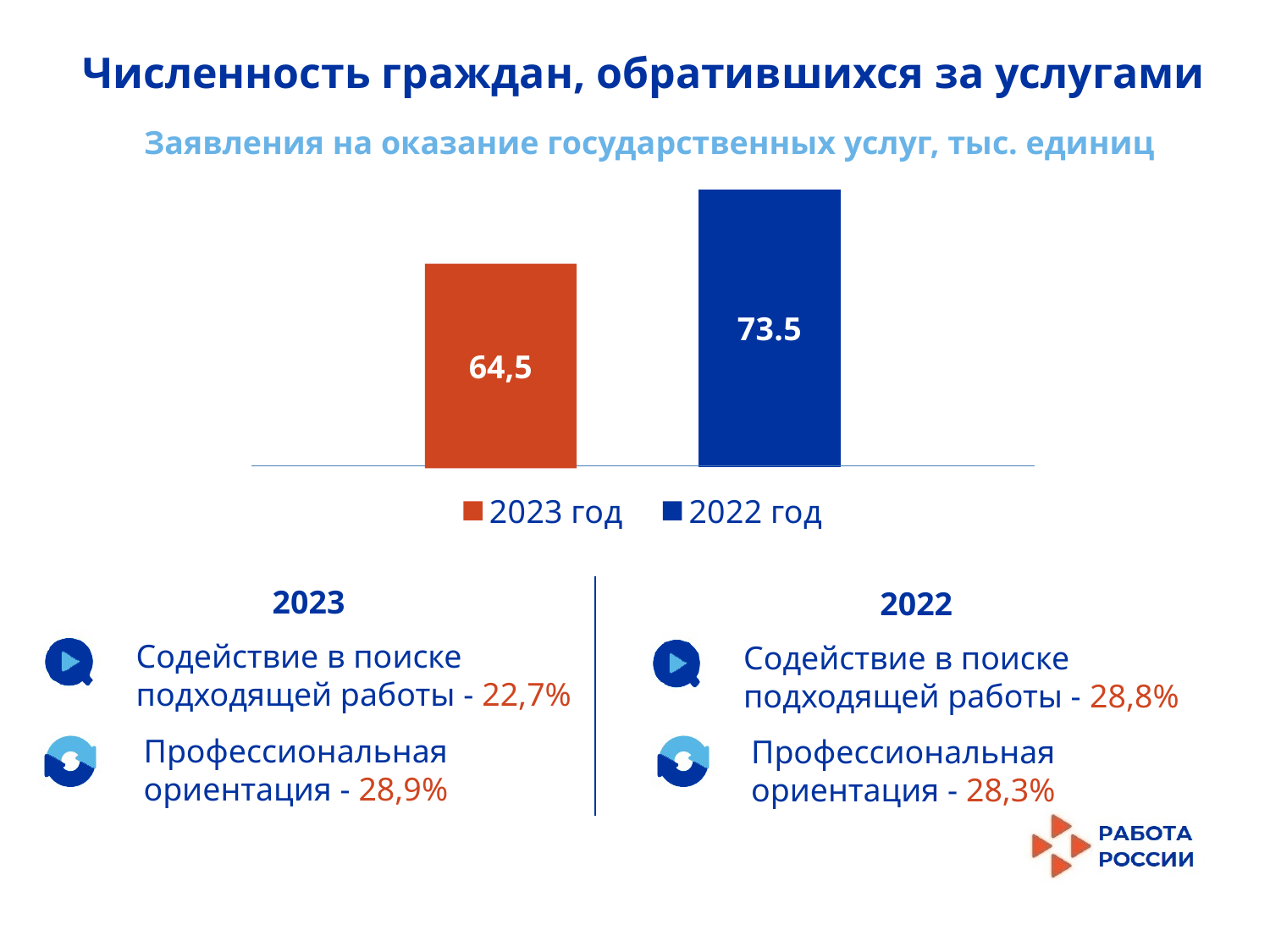
Which year has the lower value in the chart? 2023 год How many series does the legend list? 2 Which year has the higher value, 2023 год or 2022 год? 2022 год Is the value for 2023 год greater or less than 70? less What is the value shown for 2022 год? 73.5 Is the value for 2023 год larger or smaller than the value for 2022 год? smaller Which colour is used for the 2022 год bar? blue What type of chart is shown on the slide? bar chart What is the title of the chart? Заявления на оказание государственных услуг, тыс. единиц What is the value shown for 2023 год? 64,5 By how much does the value for 2022 год exceed the value for 2023 год? 9 How many bars are plotted in the chart? 2